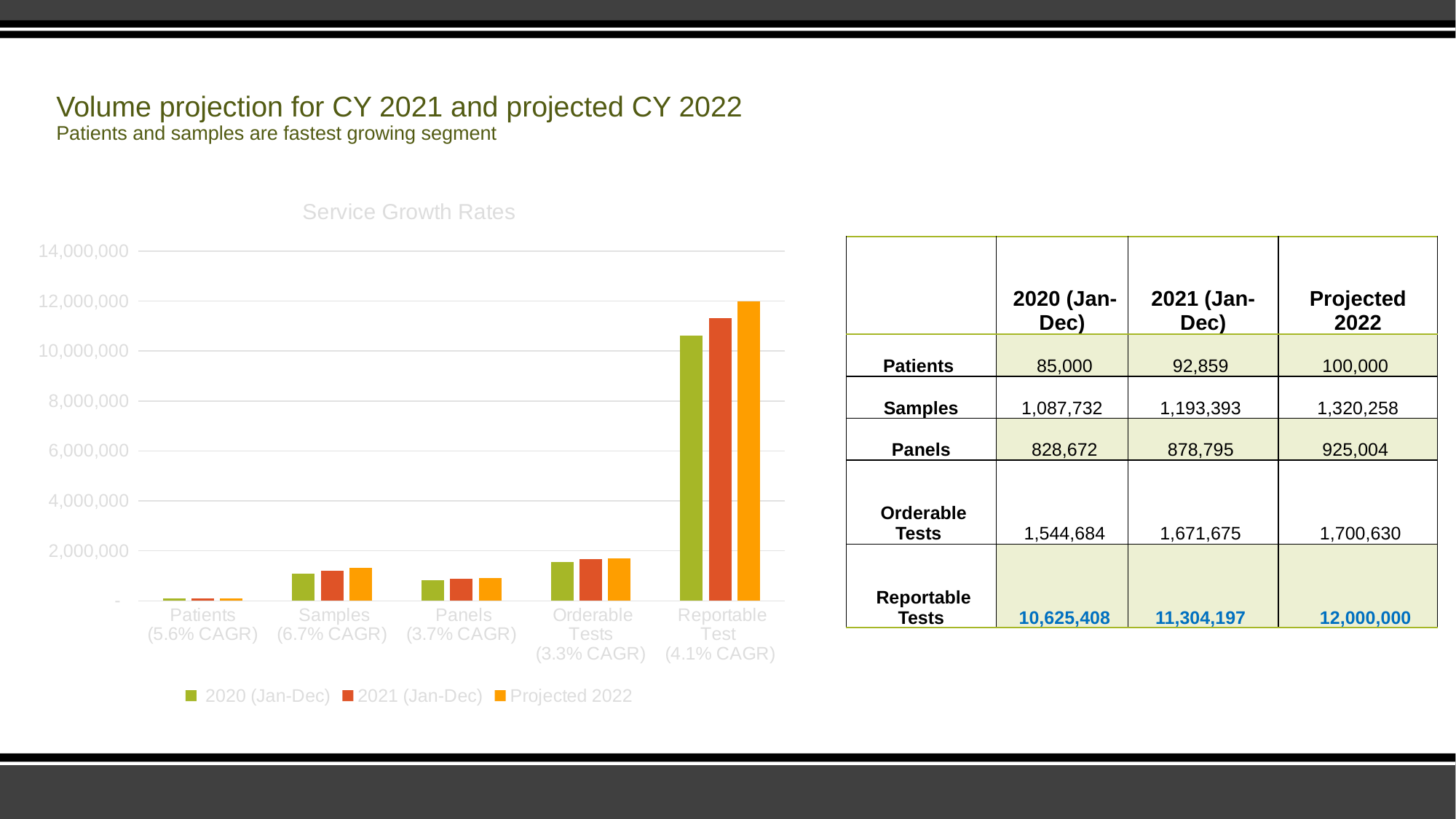
Which category has the lowest bars in the chart? Patients Which category has the highest bars in the chart? Reportable Test Do the values for Samples rise or fall from 2020 (Jan-Dec) to Projected 2022? rise What type of chart is shown on the slide? bar chart How many series does the chart legend list? 3 Using the table values, what is the difference between the Projected 2022 and 2020 (Jan-Dec) values for Patients? 15,000 Is the 2020 (Jan-Dec) value for Orderable Tests greater or less than 2,000,000? less Is the Projected 2022 value for Reportable Test greater or less than 10,000,000? greater How many categories are shown on the x axis of the chart? 5 What is the title of the chart? Service Growth Rates According to the table, what is the Projected 2022 value for Reportable Tests? 12,000,000 According to the table, what is the 2021 (Jan-Dec) value for Samples? 1,193,393